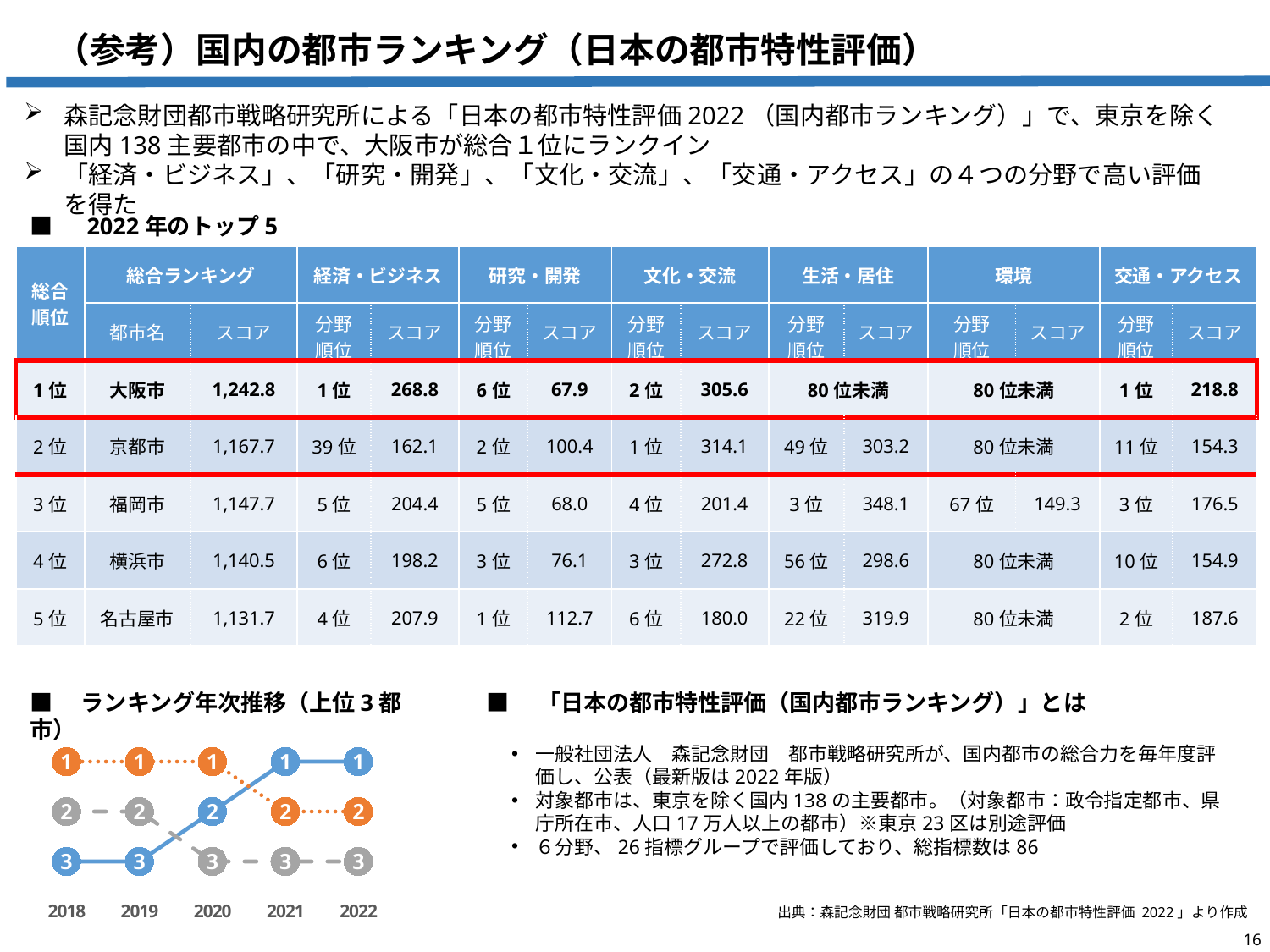
In the ranking year transition chart, which line is ranked 1 in 2018? the orange line In the ranking year transition chart, what rank does the orange line show in 2020? 1 In the ranking year transition chart, in which year does the blue line first reach rank 1? 2021 In the ranking year transition chart, how many years are shown on the x axis? 5 What is the first year shown on the x axis of the ranking year transition chart? 2018 In the ranking year transition chart, what rank does the gray line show in 2020? 3 In the ranking year transition chart, what rank does the blue line show in 2022? 1 In the ranking year transition chart, what rank does the blue line show in 2018? 3 In the ranking year transition chart, how many lines (cities) are plotted? 3 In the ranking year transition chart, does the rank of the blue line improve (move toward 1) or worsen from 2018 to 2022? improve What kind of chart is the ranking year transition chart at the bottom left of the slide? line chart In the ranking year transition chart, what rank does the orange line show in 2022? 2